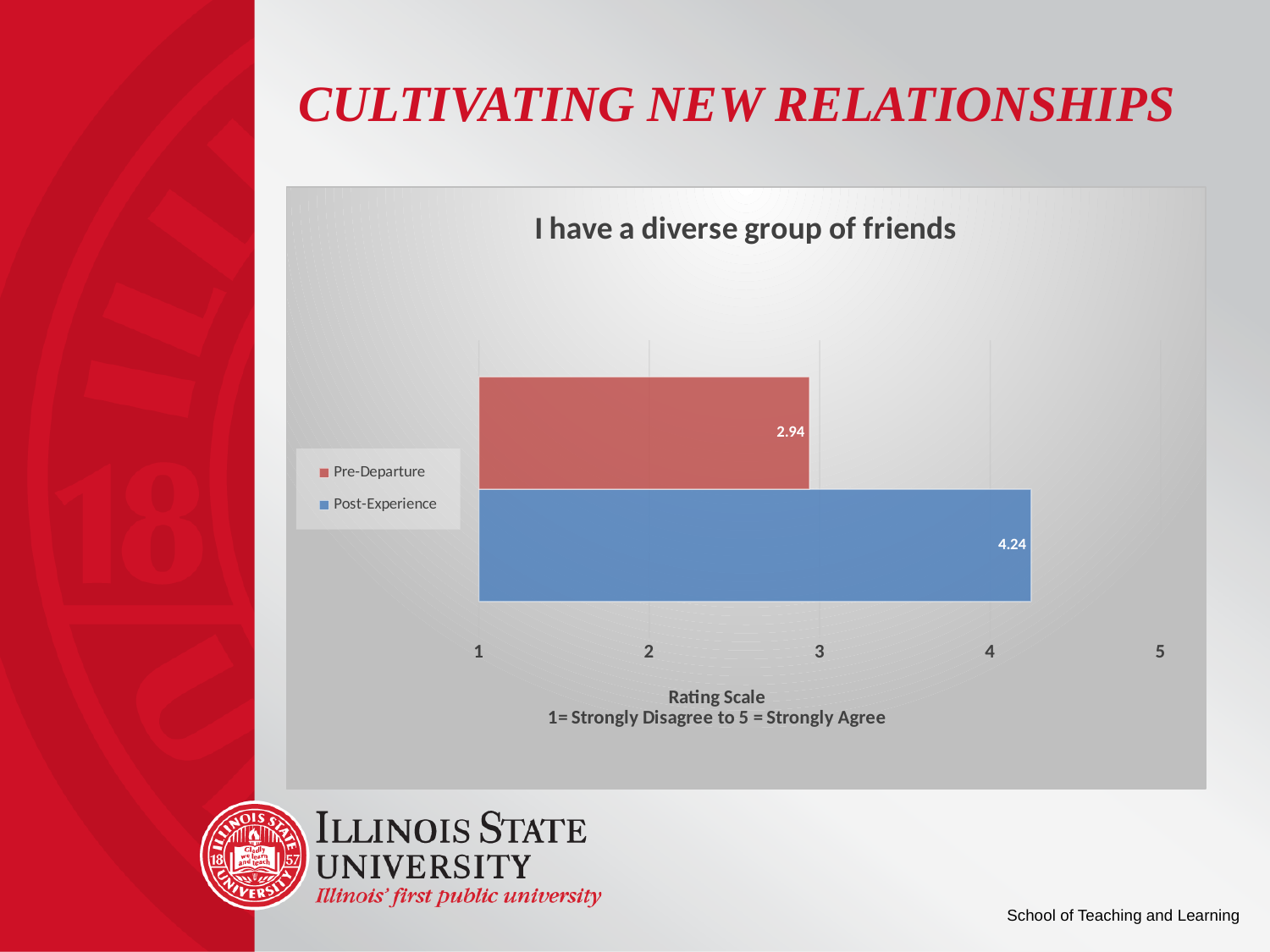
What kind of chart is shown on the slide? bar chart Is the Post-Experience value greater or less than 4? greater What is the highest value shown on the x axis of the chart? 5 What is the difference between the Post-Experience and Pre-Departure values? 1.3 What is the title of the chart? I have a diverse group of friends What is the Post-Experience value in the chart? 4.24 Which series has the lowest value in the chart? Pre-Departure Which series has the higher value, Pre-Departure or Post-Experience? Post-Experience How many series does the legend list? 2 What is the Pre-Departure value in the chart? 2.94 Is the Pre-Departure value greater or less than 3? less What is the x-axis label of the chart? Rating Scale 1= Strongly Disagree to 5 = Strongly Agree